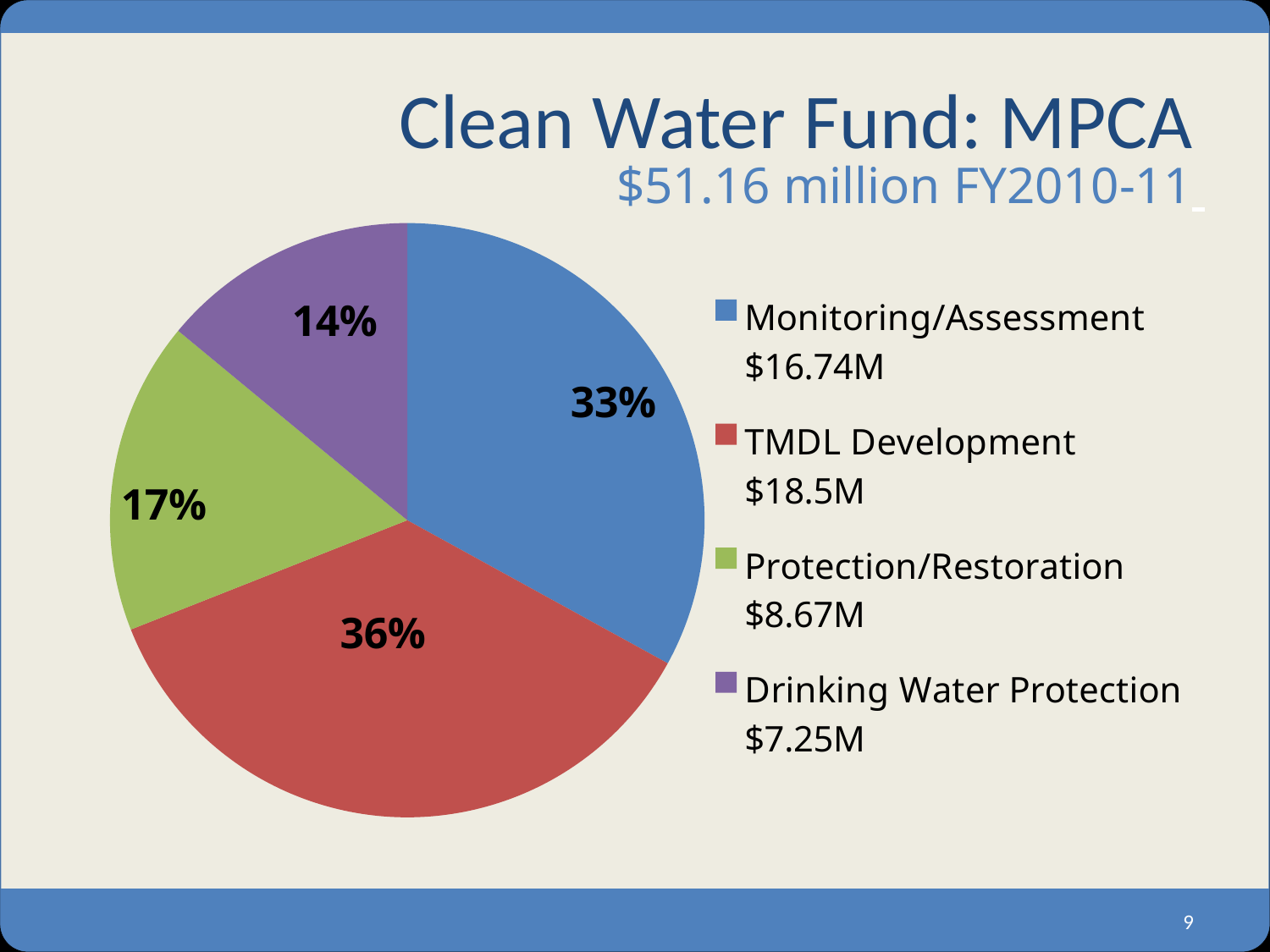
Which slice is larger, Monitoring/Assessment or Protection/Restoration? Monitoring/Assessment Which category has the largest share of the pie? TMDL Development What is the difference in percentage points between the TMDL Development and Protection/Restoration slices? 19 What dollar amount is listed for Drinking Water Protection in the legend? $7.25M How many categories are shown in the pie chart? 4 What percentage share does TMDL Development have in the pie chart? 36% What dollar amount is listed for Monitoring/Assessment in the legend? $16.74M Which category has the smallest share of the pie? Drinking Water Protection What percentage share does Protection/Restoration have in the pie chart? 17% What percentage share does Monitoring/Assessment have in the pie chart? 33% What type of chart is shown on the slide? pie chart